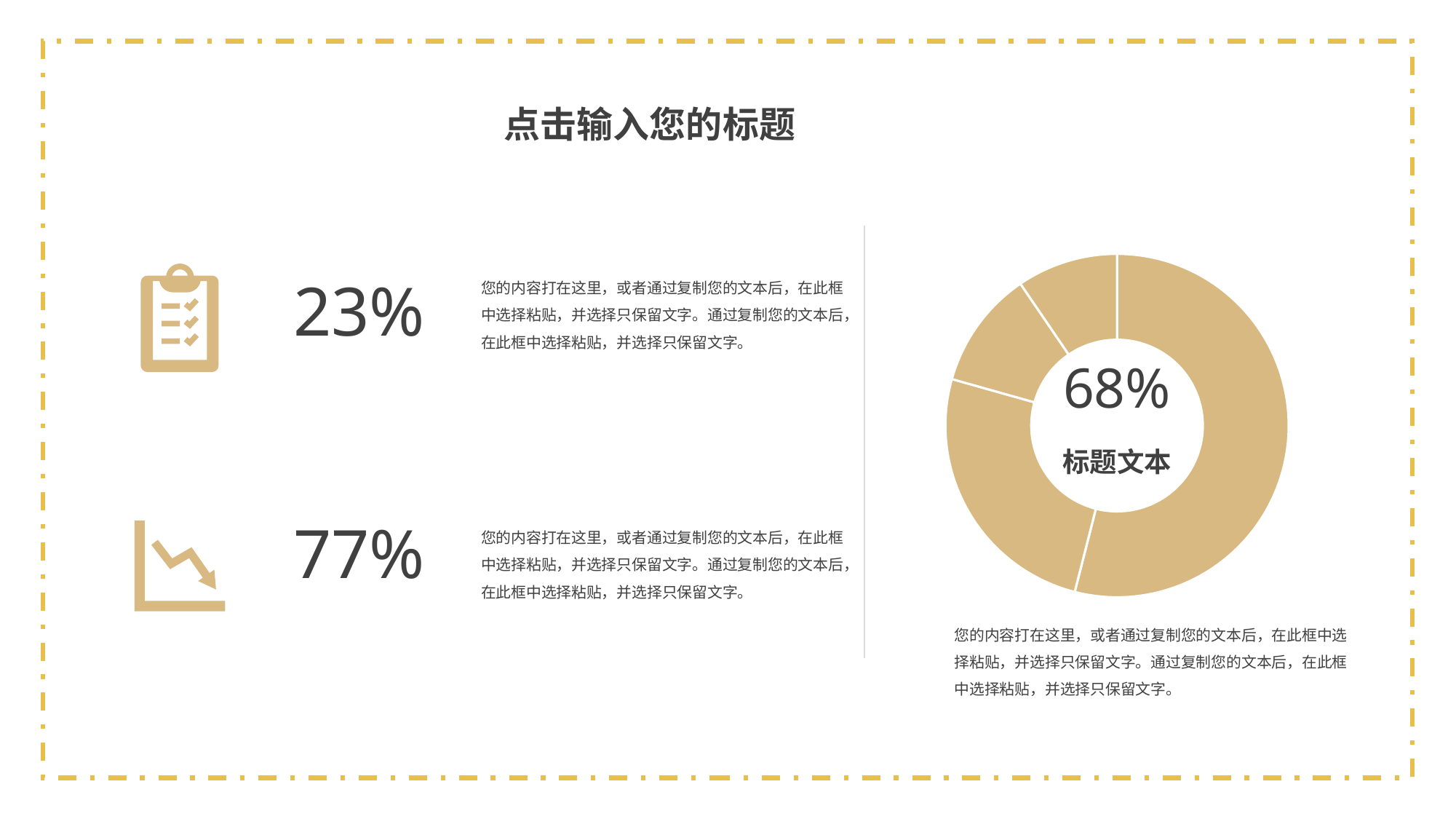
Is the largest slice of the doughnut chart greater or less than 50% of the ring? greater How many slices does the doughnut chart on the right have? 4 What text label appears below the percentage in the centre of the doughnut chart? 标题文本 Are the slices of the doughnut chart drawn in different colours or all in the same colour? all in the same colour What percentage value is printed in the centre of the doughnut chart? 68% What kind of chart is shown on the right side of the slide? doughnut chart